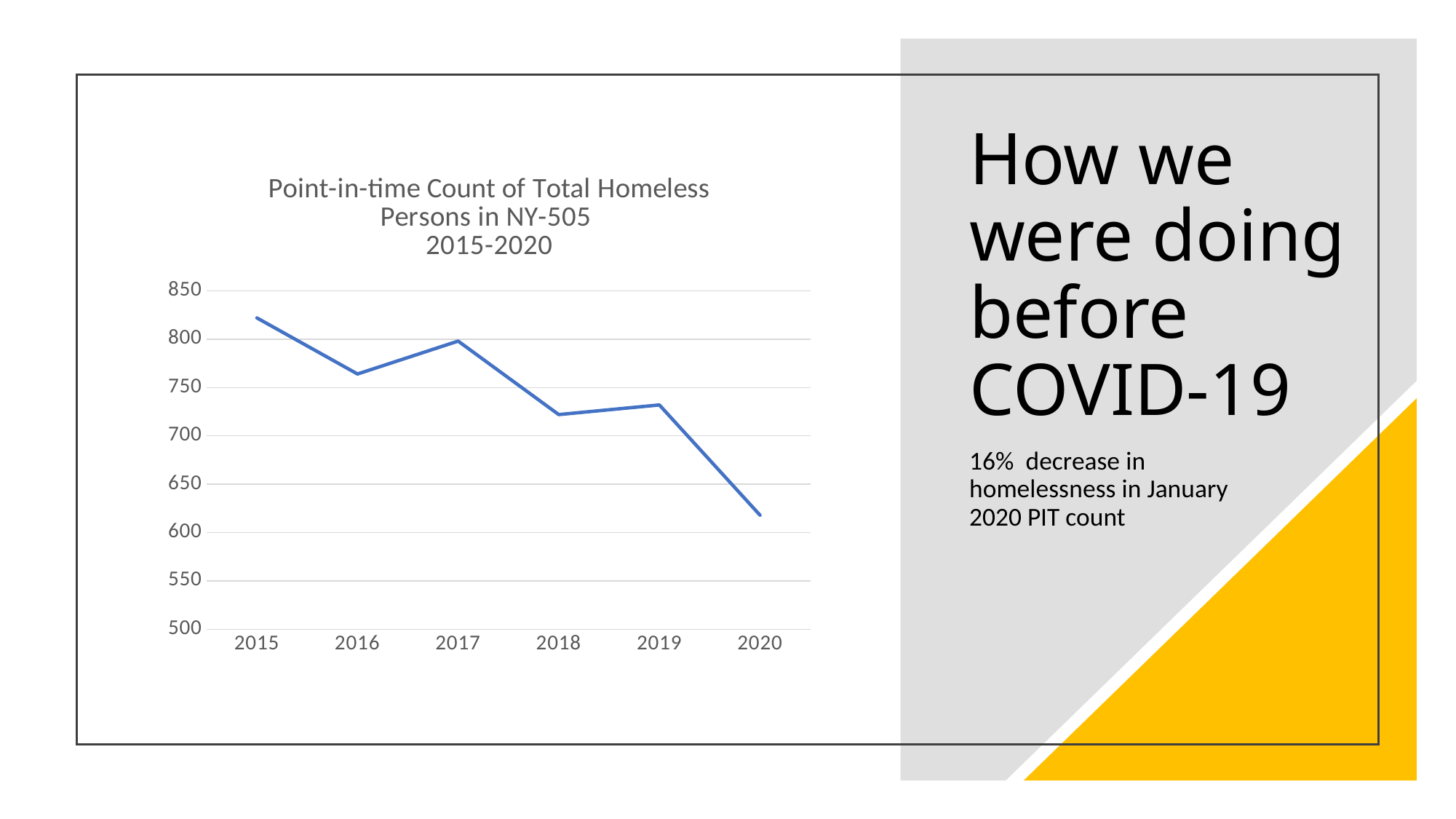
Is the value for 2016 greater or less than 750? greater What is the title of the chart? Point-in-time Count of Total Homeless Persons in NY-505 2015-2020 Which year has a higher count, 2016 or 2017? 2017 Which year has the highest point-in-time count? 2015 Is the value for 2020 greater or less than 650? less Overall, do the values rise or fall from 2015 to 2020? fall How many years are plotted on the x axis of the chart? 6 Is the value for 2020 greater or less than 600? greater Which year has the lowest point-in-time count? 2020 What kind of chart is shown on the slide? line chart